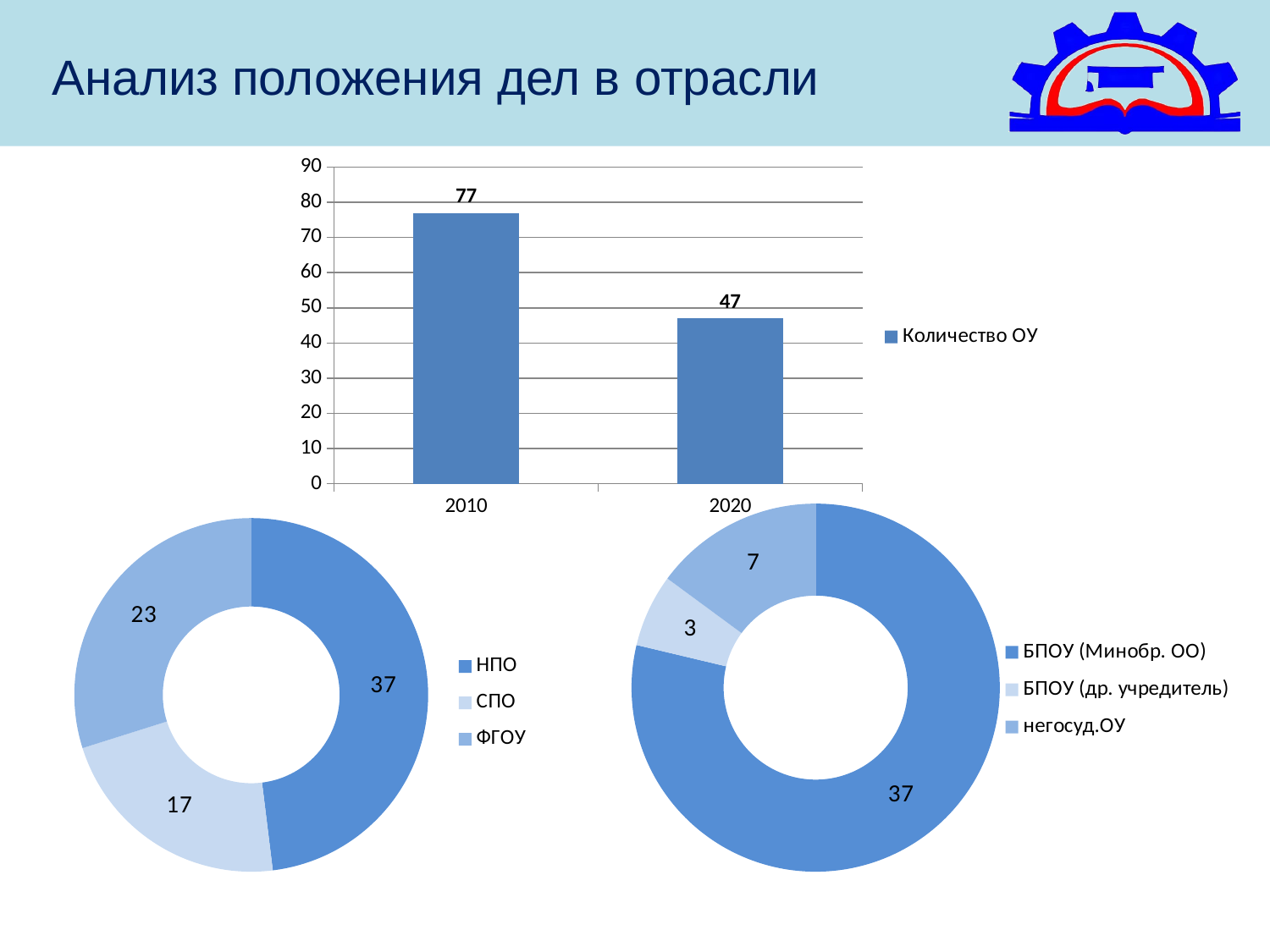
In the bar chart at the top of the slide, what series name does the legend show? Количество ОУ How many categories does the legend of the doughnut chart at the bottom left of the slide list? 3 In the doughnut chart at the bottom left of the slide, what is the value for СПО? 17 In the bar chart at the top of the slide, what is the value for 2020? 47 What kind of chart is the chart at the top of the slide? bar chart In the bar chart at the top of the slide, do the values rise or fall from 2010 to 2020? fall In the doughnut chart at the bottom right of the slide, which category has the smallest value? БПОУ (др. учредитель) In the doughnut chart at the bottom right of the slide, what is the value for негосуд.ОУ? 7 In the bar chart at the top of the slide, what is the value for 2010? 77 In the doughnut chart at the bottom left of the slide, which category has the largest value? НПО In the bar chart at the top of the slide, what is the difference between the 2010 and 2020 values? 30 In the doughnut chart at the bottom left of the slide, what is the difference between the values for ФГОУ and СПО? 6